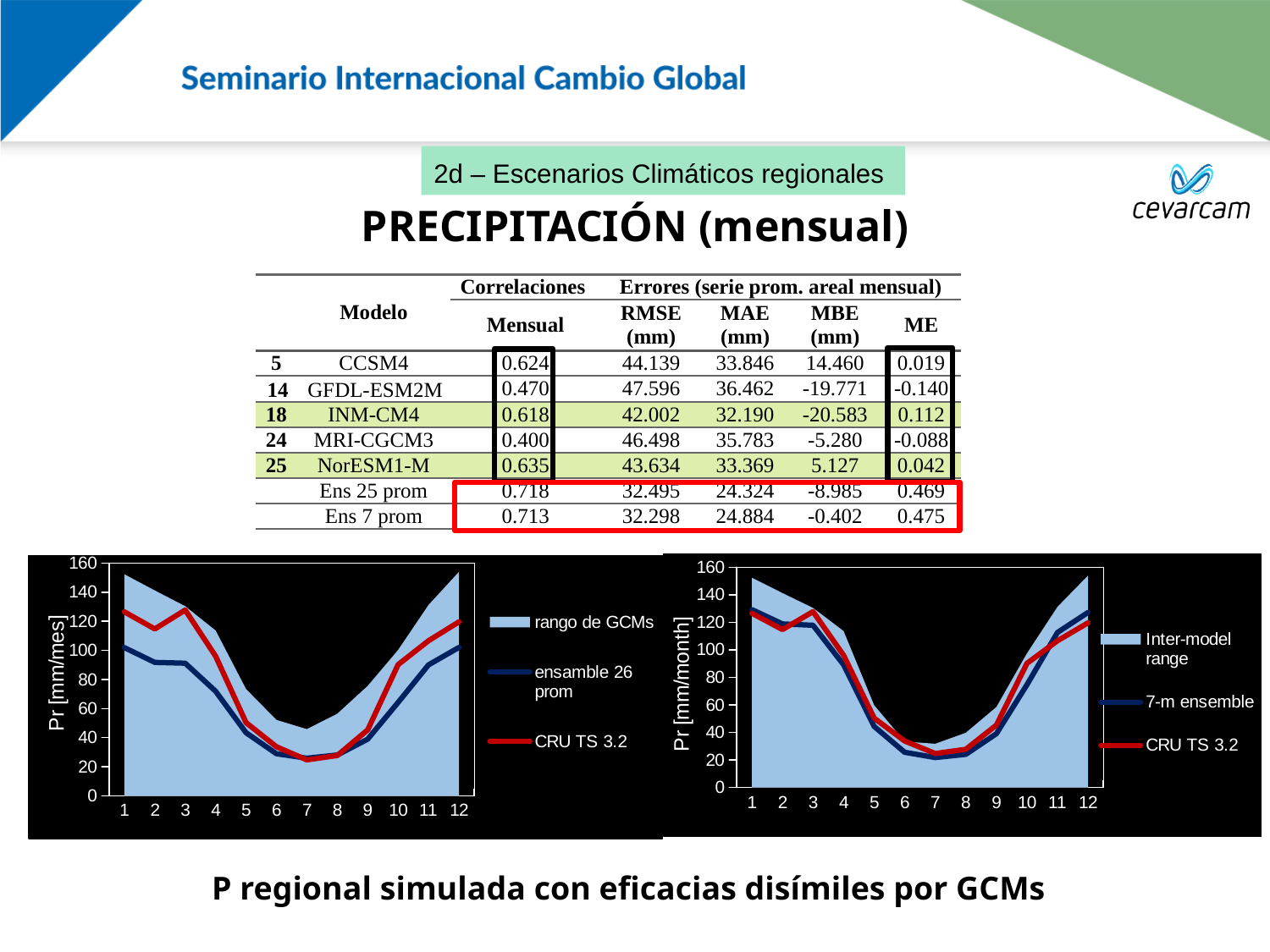
On the left chart, is the value of CRU TS 3.2 at month 1 greater or less than 100? greater On the left chart, how many series does the legend list? 3 On the left chart, is the value of ensamble 26 prom at month 7 greater or less than 40? less On the left chart, what is the label of the y axis? Pr [mm/mes] On the right chart, does the CRU TS 3.2 series rise or fall from month 7 to month 12? rise On the left chart, does the ensamble 26 prom series rise or fall from month 1 to month 7? fall On the right chart, what are the three legend entries? Inter-model range, 7-m ensemble, CRU TS 3.2 On the right chart, is the value of CRU TS 3.2 at month 7 greater or less than 40? less What kind of chart is the right chart? combination area and line chart On the left chart, how many points are plotted along the x axis? 12 On the left chart, at month 1, which is larger: CRU TS 3.2 or ensamble 26 prom? CRU TS 3.2